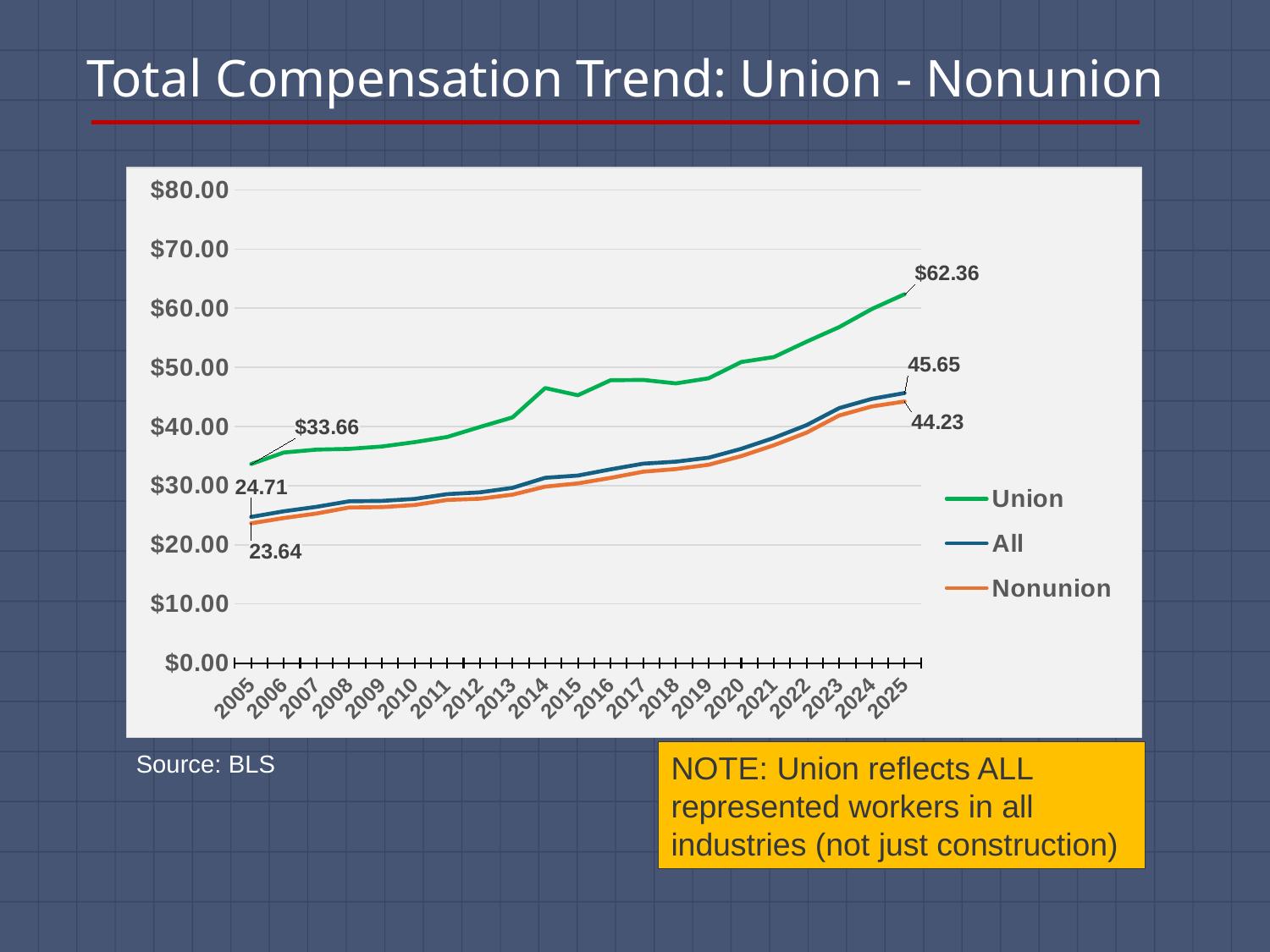
What is the All value in 2005? 24.71 What is the Union value in 2025? $62.36 By how much did the Union value increase from 2005 to 2025? $28.70 Which series has the higher value in 2025, Union or Nonunion? Union What is the All value in 2025? 45.65 What kind of chart is shown on the slide? line chart How many years are shown on the x axis? 21 What is the Nonunion value in 2005? 23.64 Is the Union value for 2014 greater or less than $40.00? greater How many series does the legend list? 3 What is the Union value in 2005? $33.66 What is the difference between the All and Nonunion values in 2025? 1.42